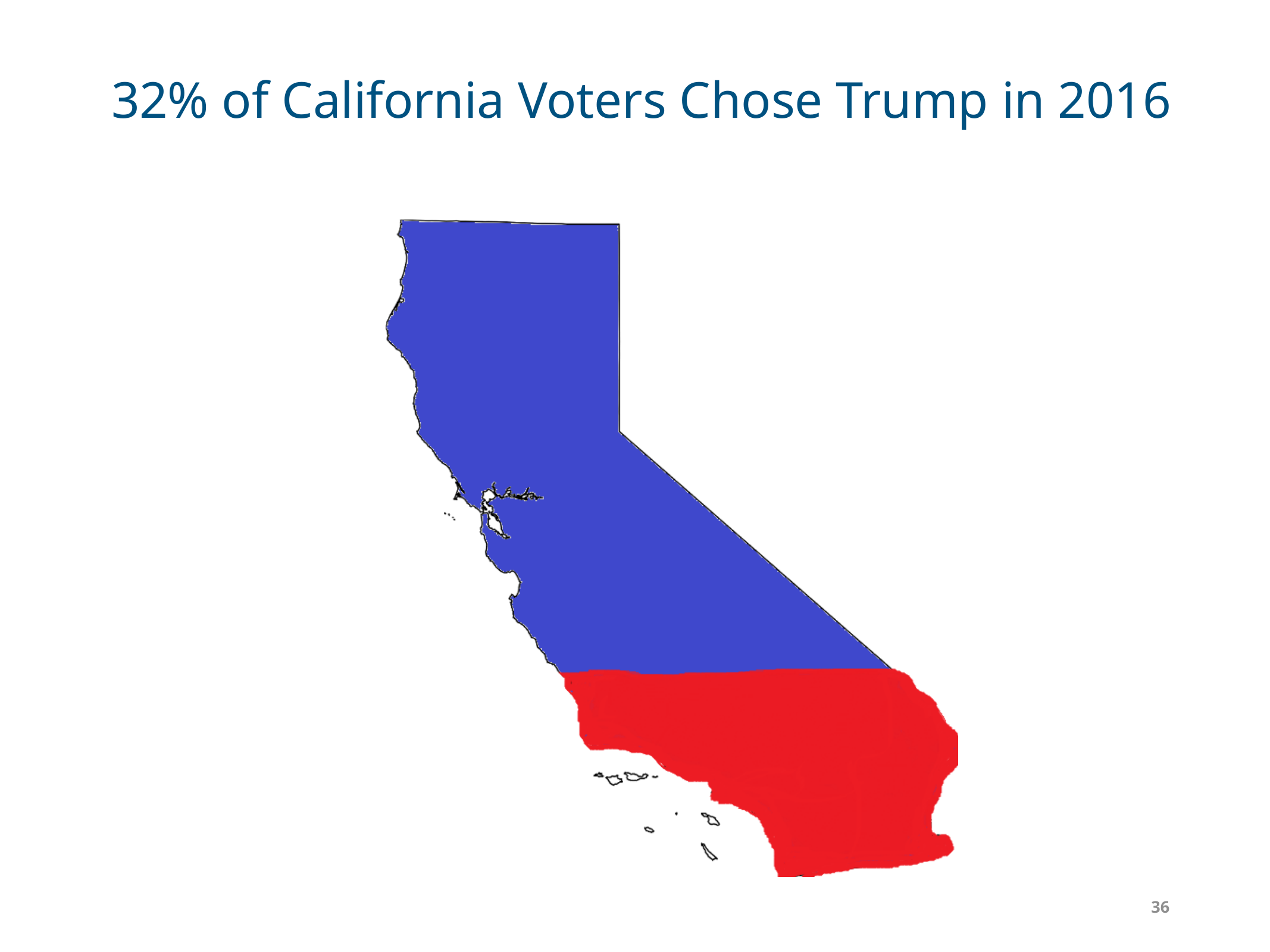
Which year does the slide's map of California voters refer to? 2016 Is the share of California voters who chose Trump in 2016, as stated on the slide, greater or less than 50%? less According to the slide title, what percentage of California voters chose Trump in 2016? 32% What colour is the southern portion of the California map on the slide? Red